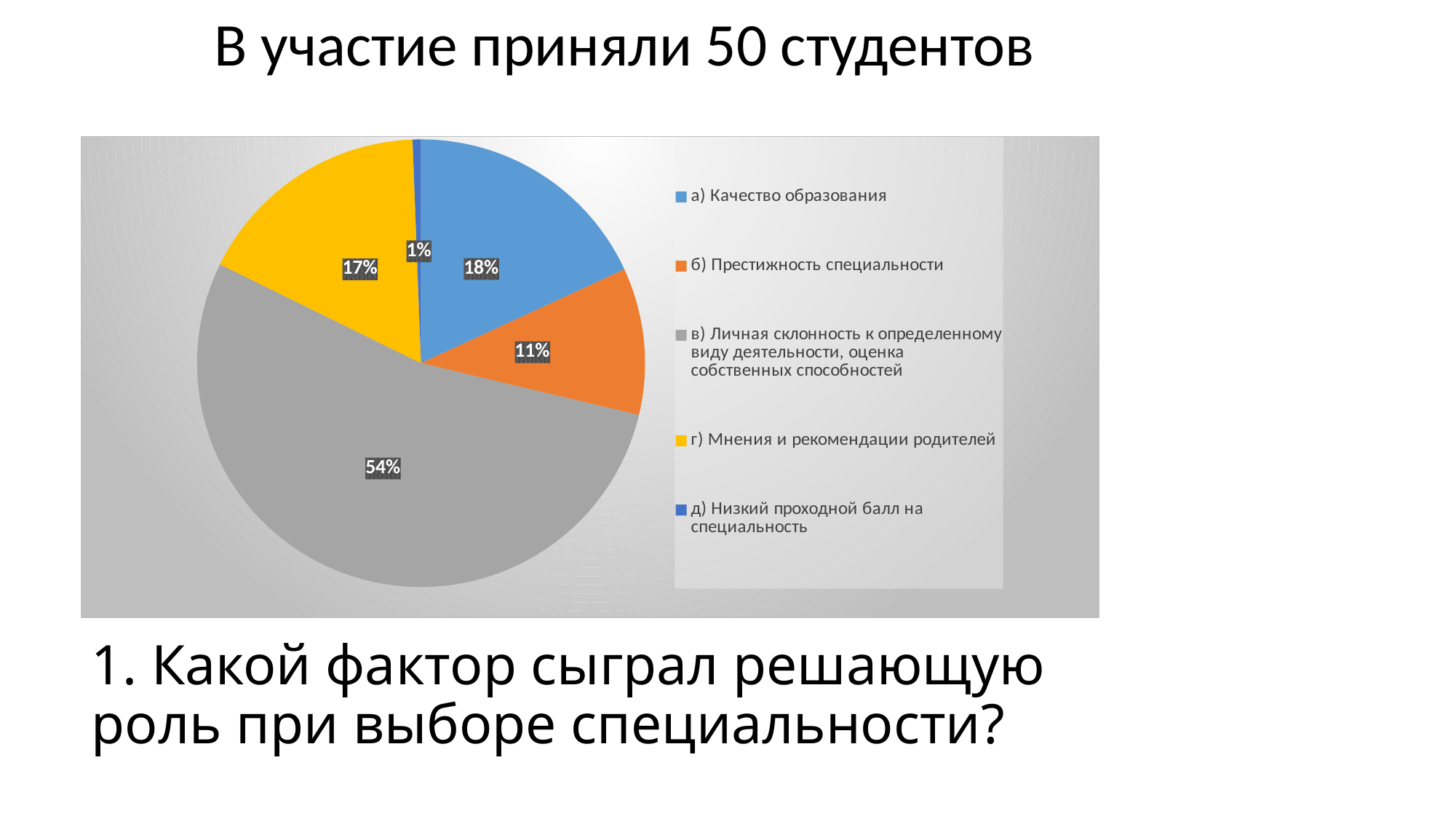
Which category has the largest slice of the pie? в) Личная склонность к определенному виду деятельности, оценка собственных способностей What share of the pie does "д) Низкий проходной балл на специальность" have? 1% What share of the pie does "в) Личная склонность к определенному виду деятельности, оценка собственных способностей" have? 54% What share of the pie does "а) Качество образования" have? 18% How many categories does the pie chart have? 5 What colour is the slice for "г) Мнения и рекомендации родителей"? yellow Which is larger: the share for "а) Качество образования" or the share for "г) Мнения и рекомендации родителей"? а) Качество образования Which category has the smallest slice of the pie? д) Низкий проходной балл на специальность What kind of chart is shown on the slide? pie chart What is the difference between the shares of "а) Качество образования" and "б) Престижность специальности"? 7%